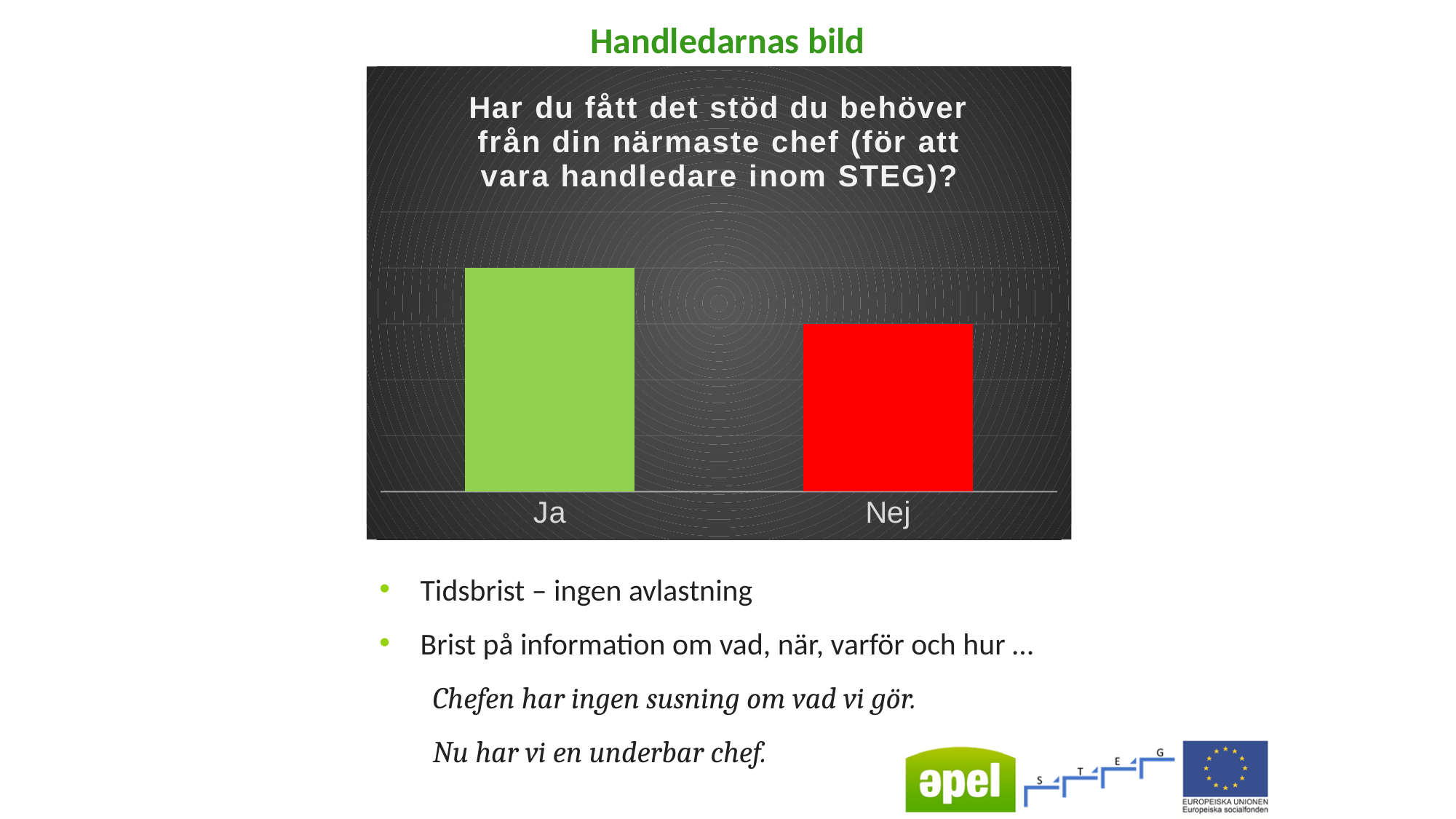
Which bar is taller, Ja or Nej? Ja What colour is the bar for Nej? red How many categories are shown in the chart? 2 What is the title of the chart? Har du fått det stöd du behöver från din närmaste chef (för att vara handledare inom STEG)? What kind of chart is shown on the slide? bar chart Which category has the highest bar in the chart? Ja Which category has the lowest bar in the chart? Nej What are the category labels on the x axis of the chart? Ja, Nej